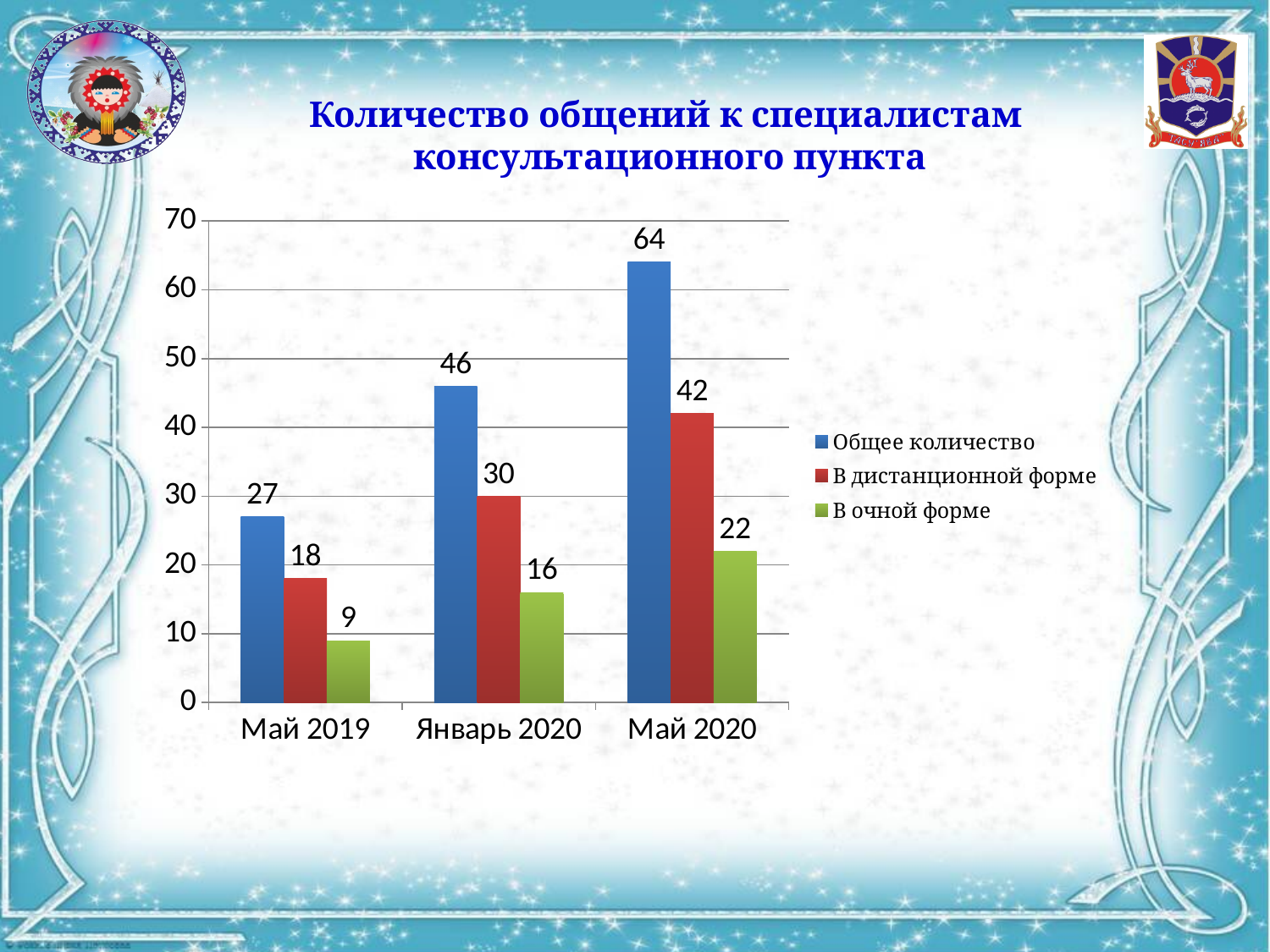
What is the title of the chart? Количество общений к специалистам консультационного пункта What is the value of 'В очной форме' for Май 2019? 9 How many categories are shown on the x axis? 3 Which category has the lowest value for 'В очной форме'? Май 2019 What kind of chart is shown on the slide? Bar chart What is the difference between 'Общее количество' for Май 2020 and Май 2019? 37 How many series does the legend list? 3 Which category has the highest value for 'Общее количество'? Май 2020 Do the values for 'В очной форме' rise or fall from Май 2019 to Май 2020? Rise Which is larger: 'В дистанционной форме' for Май 2020 or 'Общее количество' for Январь 2020? Общее количество for Январь 2020 What is the value of 'В дистанционной форме' for Январь 2020? 30 What is the value of 'Общее количество' for Май 2020? 64